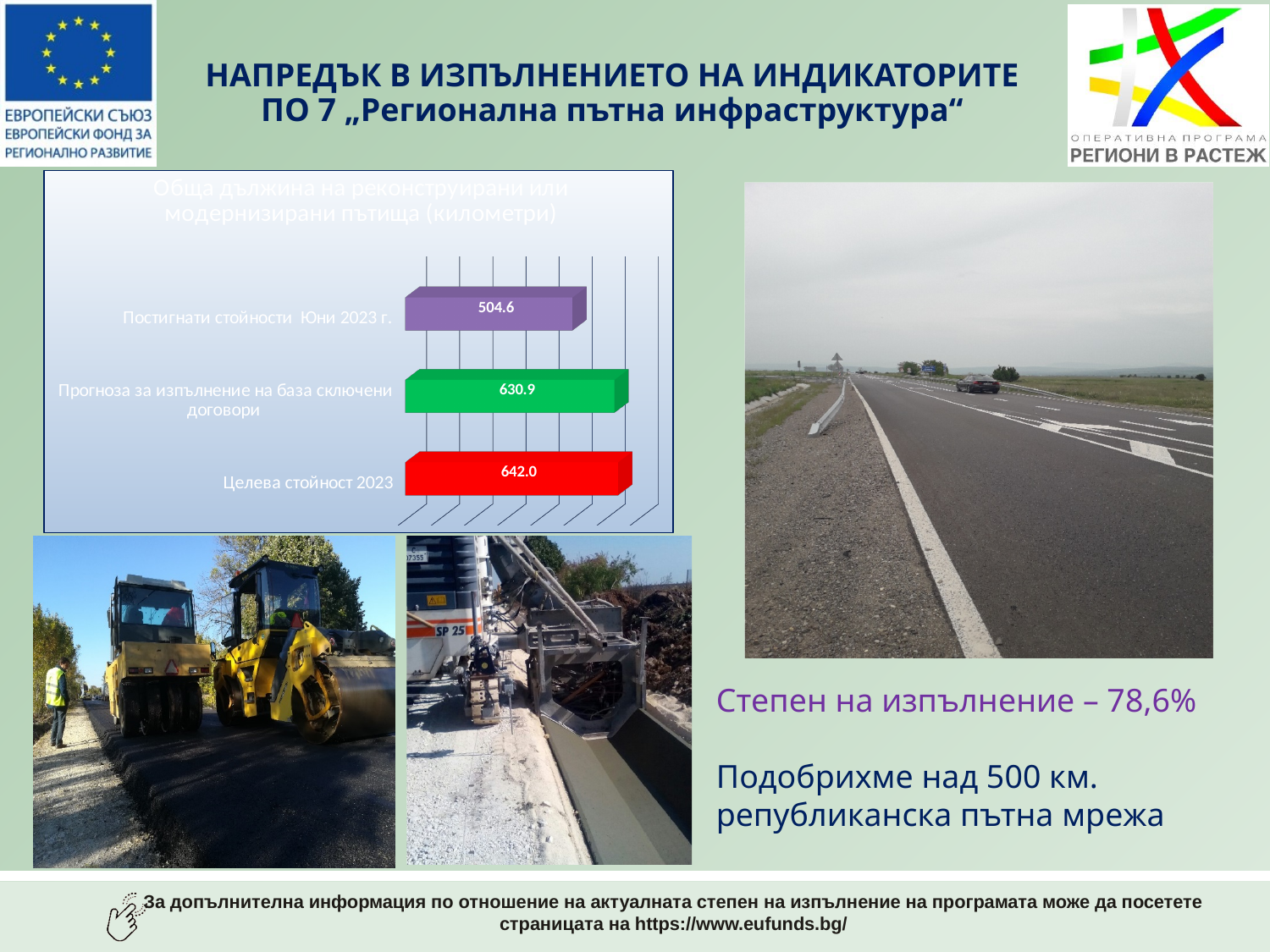
What colour is the bar for "Целева стойност 2023"? Red How many categories are shown in the chart? 3 Which is larger: the value for "Постигнати стойности Юни 2023 г." or the value for "Прогноза за изпълнение на база сключени договори"? Прогноза за изпълнение на база сключени договори What type of chart is shown on the slide? Bar chart What is the difference between "Прогноза за изпълнение на база сключени договори" and "Постигнати стойности Юни 2023 г."? 126.3 What is the value for "Постигнати стойности Юни 2023 г."? 504.6 What is the difference between "Целева стойност 2023" and "Постигнати стойности Юни 2023 г."? 137.4 What is the value for "Целева стойност 2023"? 642.0 Which category has the lowest value? Постигнати стойности Юни 2023 г. What is the difference between "Целева стойност 2023" and "Прогноза за изпълнение на база сключени договори"? 11.1 Which category has the highest value? Целева стойност 2023 What is the value for "Прогноза за изпълнение на база сключени договори"? 630.9